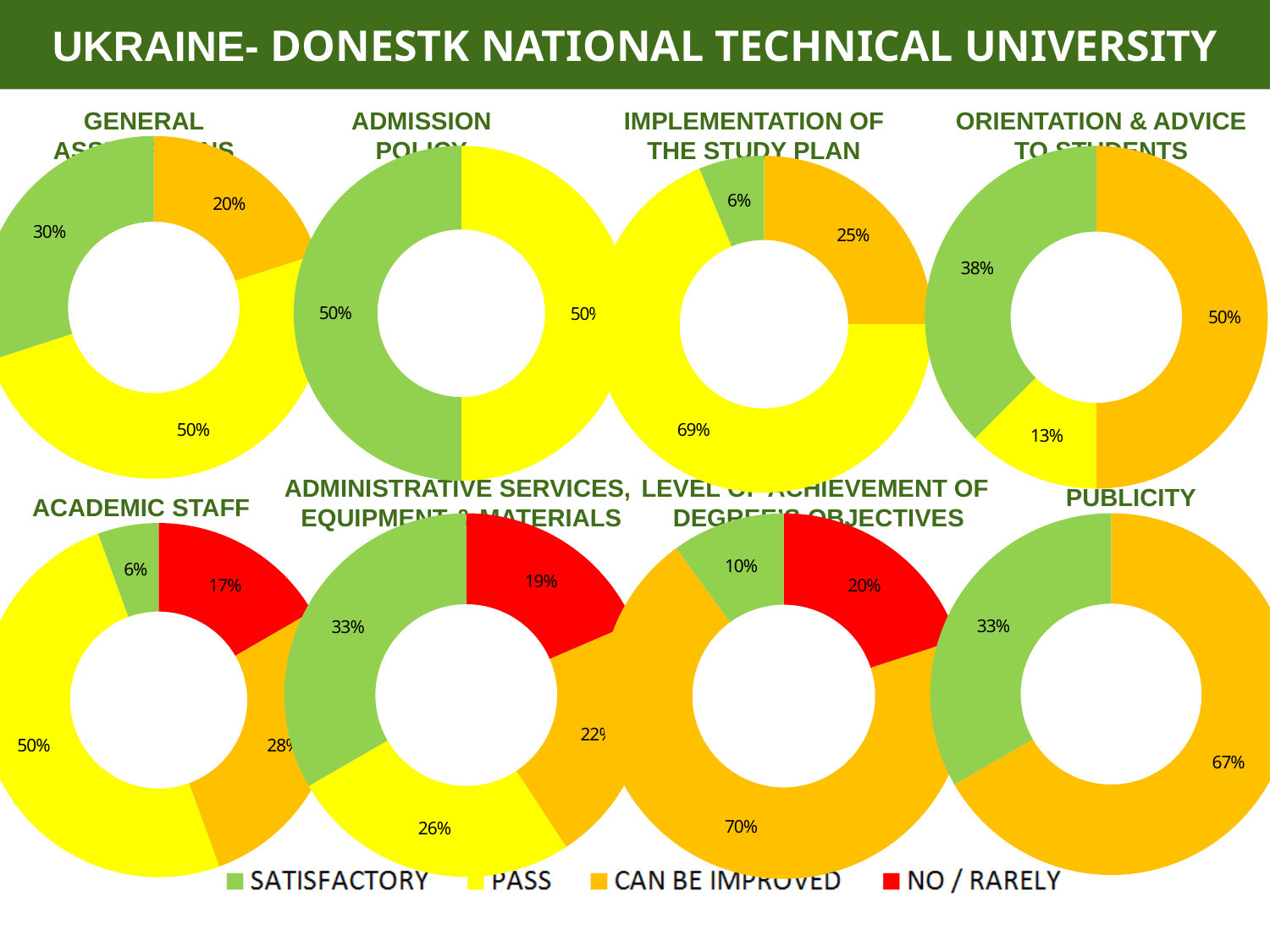
In the Orientation & Advice to Students chart, what share is Can Be Improved? 50% In the Implementation of the Study Plan chart, what share is Pass? 69% In the Admission Policy chart, what share is Satisfactory? 50% In the Administrative Services, Equipment & Materials chart, which category has the smallest share? No / Rarely In the Level of Achievement of Degree's Objectives chart, which category has the largest share? Can Be Improved Which colour represents No / Rarely in the legend? Red In the Publicity chart, what share is Can Be Improved? 67% In the Orientation & Advice to Students chart, which is larger: Satisfactory or Pass? Satisfactory What kind of chart is used on this slide? Donut (pie) chart In the Academic Staff chart, what share is No / Rarely? 17% In the Academic Staff chart, what is the difference between the Pass share and the Can Be Improved share? 22% How many categories does the legend list? 4